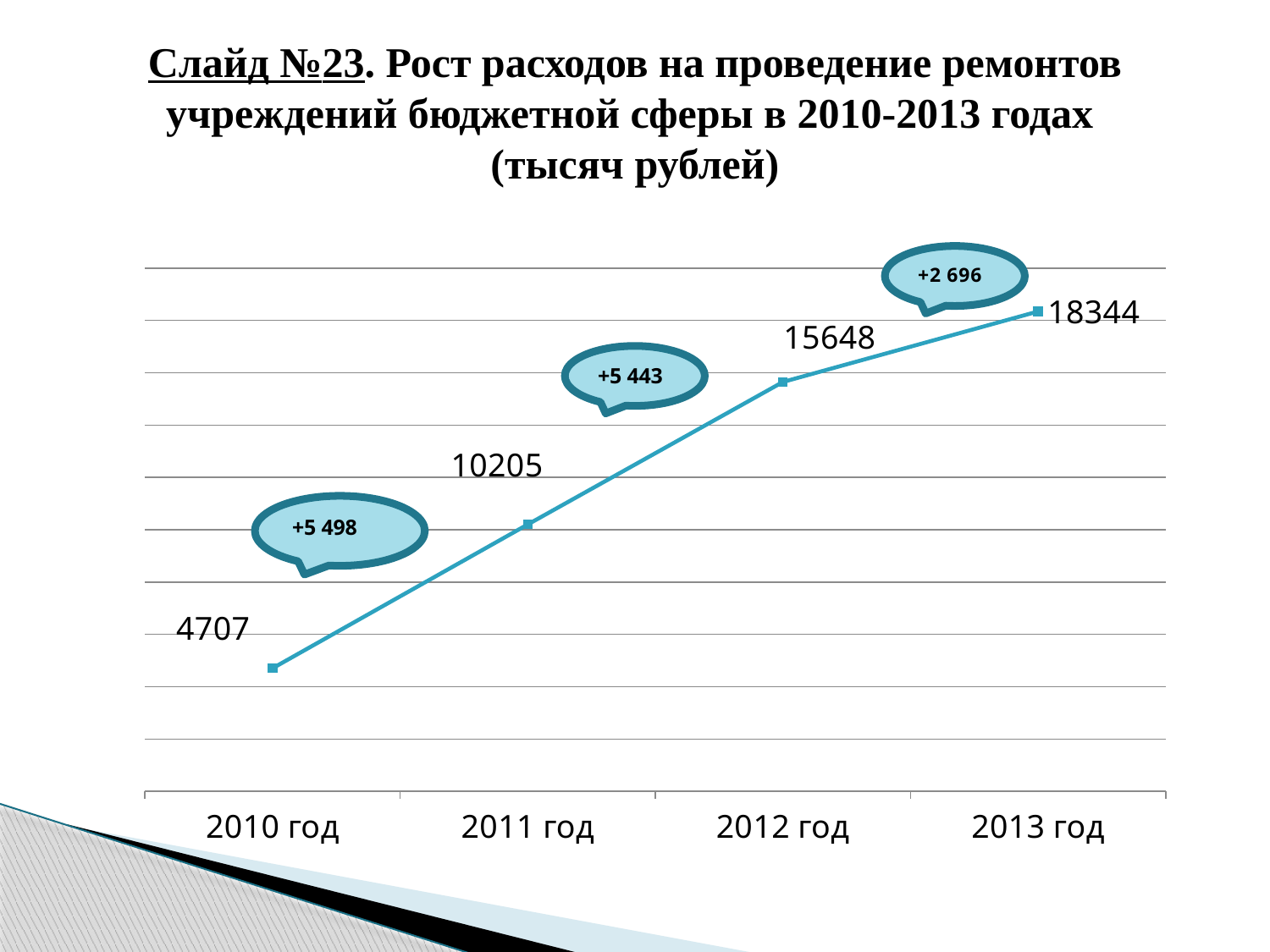
How many years are plotted on the chart? 4 What is the value for 2013 год? 18344 Which year has the highest value? 2013 год What is the value for 2012 год? 15648 What is the difference between the values for 2011 год and 2010 год? 5498 What is the value for 2010 год? 4707 Do the values rise or fall from 2010 год to 2013 год? rise Which is larger, the value for 2011 год or the value for 2012 год? 2012 год What kind of chart is shown on the slide? line chart What is the value for 2011 год? 10205 What is the difference between the values for 2013 год and 2012 год? 2696 Which year has the lowest value? 2010 год